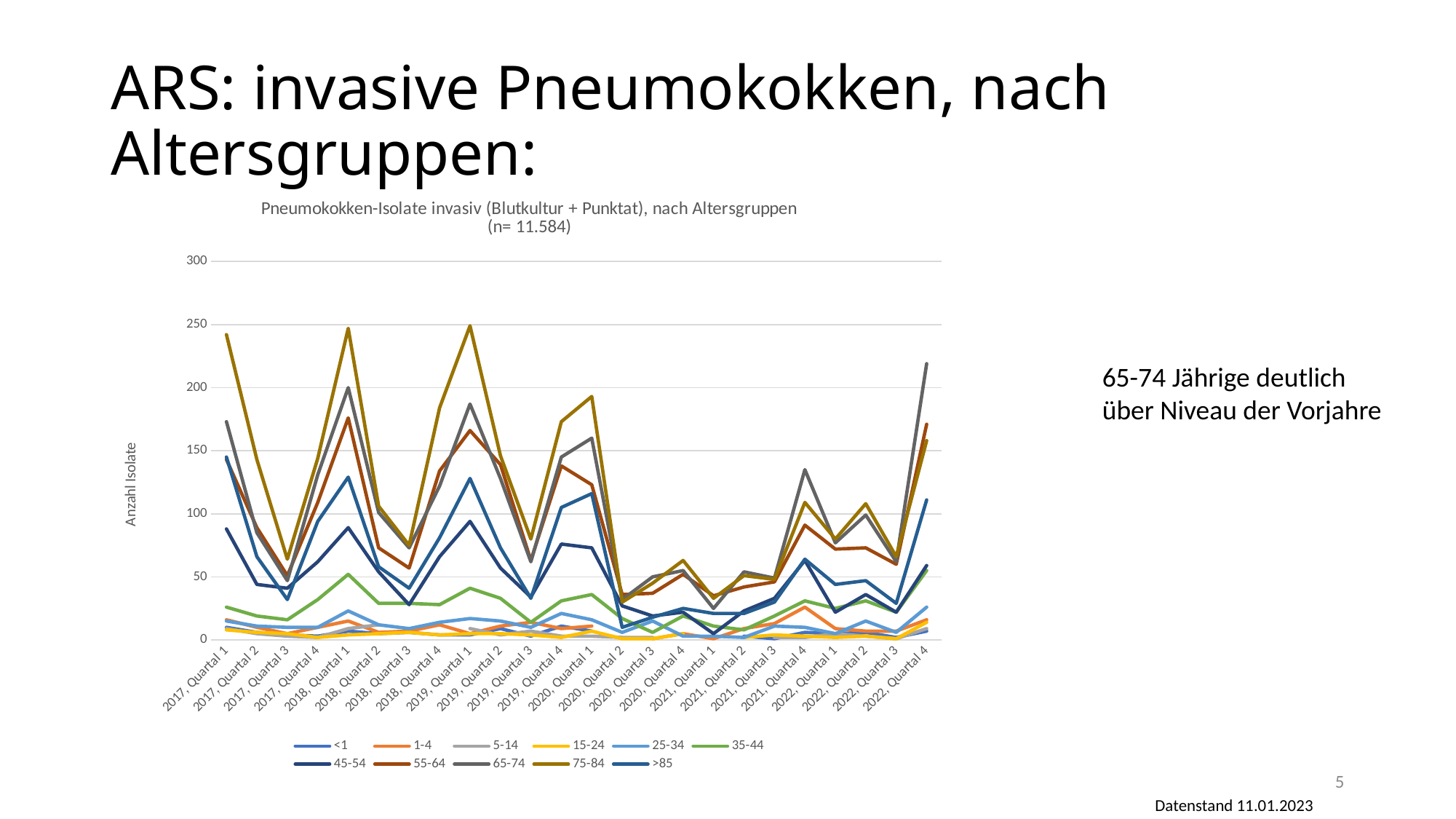
Is the value for the 65-74 series at 2022, Quartal 4 greater or less than 200? greater Which age group series has the highest value at 2017, Quartal 1? 75-84 Does the 75-84 series rise or fall from 2019, Quartal 1 to 2020, Quartal 2? fall What is the label of the y axis of the chart? Anzahl Isolate How many quarters are plotted along the x axis of the chart? 24 How many series does the legend of the chart list? 11 Is the value for the 65-74 series at 2022, Quartal 1 greater or less than 100? less What is the title of the chart? Pneumokokken-Isolate invasiv (Blutkultur + Punktat), nach Altersgruppen (n= 11.584) Is the value for the 75-84 series at 2020, Quartal 2 greater or less than 50? less What kind of chart is shown on the slide? line chart Which age group series has the highest value at 2022, Quartal 4? 65-74